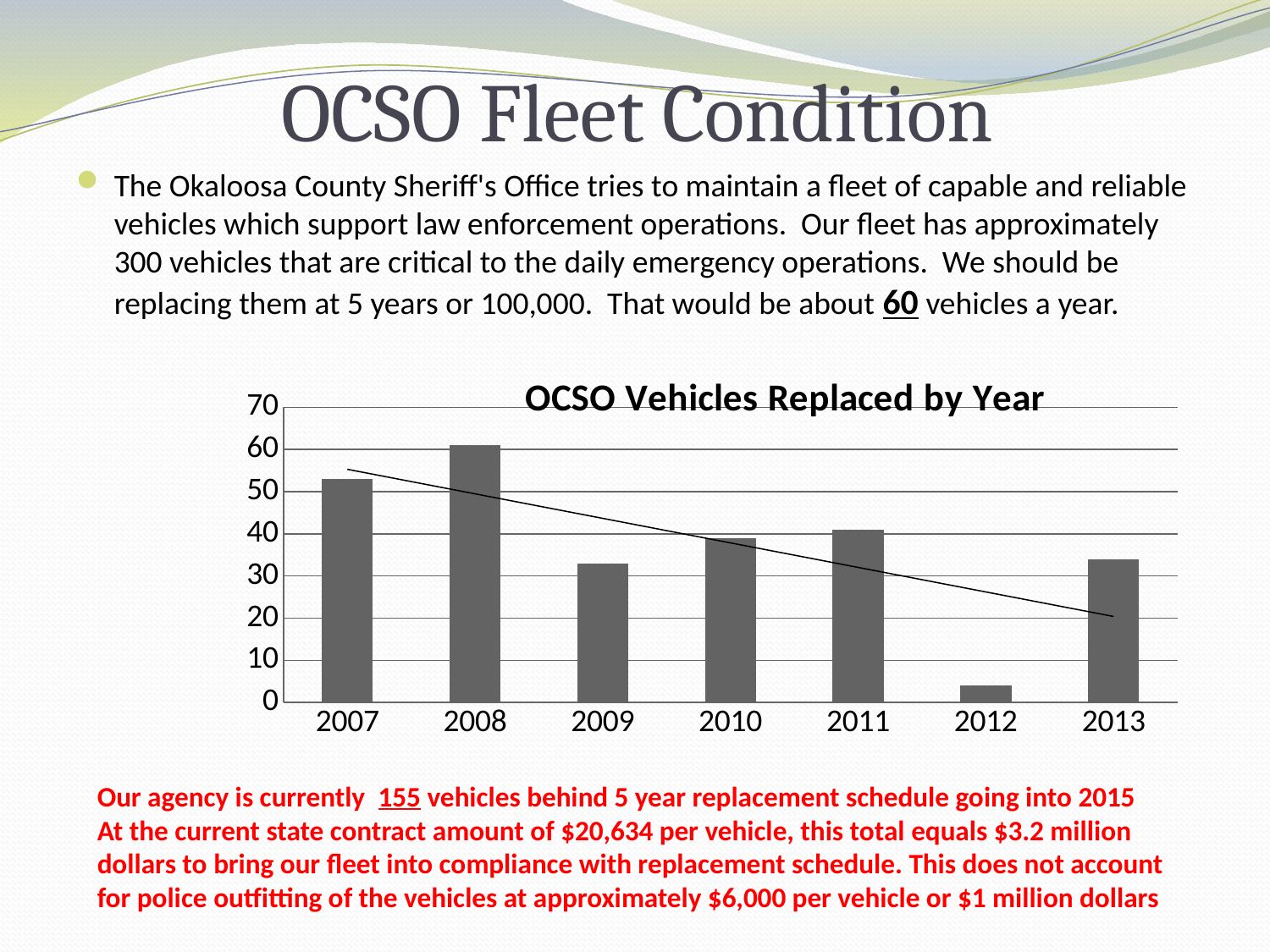
Which year had more vehicles replaced, 2007 or 2010? 2007 How many years are shown on the x axis of the chart? 7 What kind of chart is shown on the slide? bar chart Is the value for 2012 greater or less than 10? less What is the title of the chart? OCSO Vehicles Replaced by Year Which year has the lowest number of vehicles replaced? 2012 Which year has the highest number of vehicles replaced? 2008 Which year had more vehicles replaced, 2008 or 2009? 2008 Is the value for 2009 greater or less than 40? less Is the value for 2007 greater or less than 50? greater Does the overall trend of vehicles replaced from 2007 to 2013 rise or fall? fall